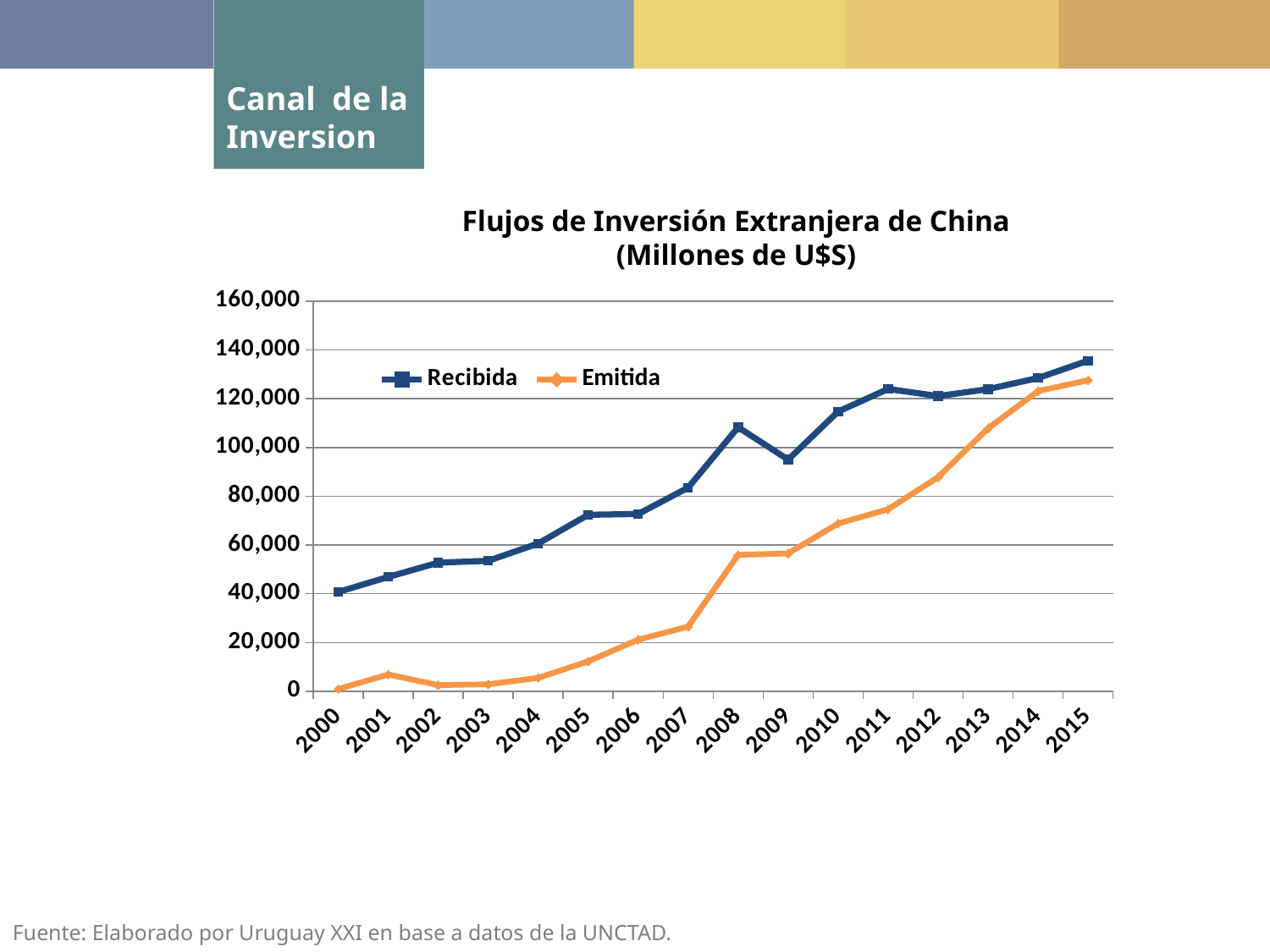
In which year is the Emitida series at its lowest? 2000 What is the title of the chart? Flujos de Inversión Extranjera de China (Millones de U$S) Does the Emitida series generally rise or fall from 2000 to 2015? rise How many years are plotted along the x axis? 16 Is the Recibida value for 2008 greater or less than 100,000? greater Is the Recibida value for 2005 greater or less than 60,000? greater How many series does the legend list? 2 What kind of chart is shown on the slide? line chart In which year is the Recibida series at its lowest? 2000 In which year is the Recibida series at its highest? 2015 In 2009, which series has the larger value, Recibida or Emitida? Recibida Is the Emitida value for 2007 greater or less than 40,000? less